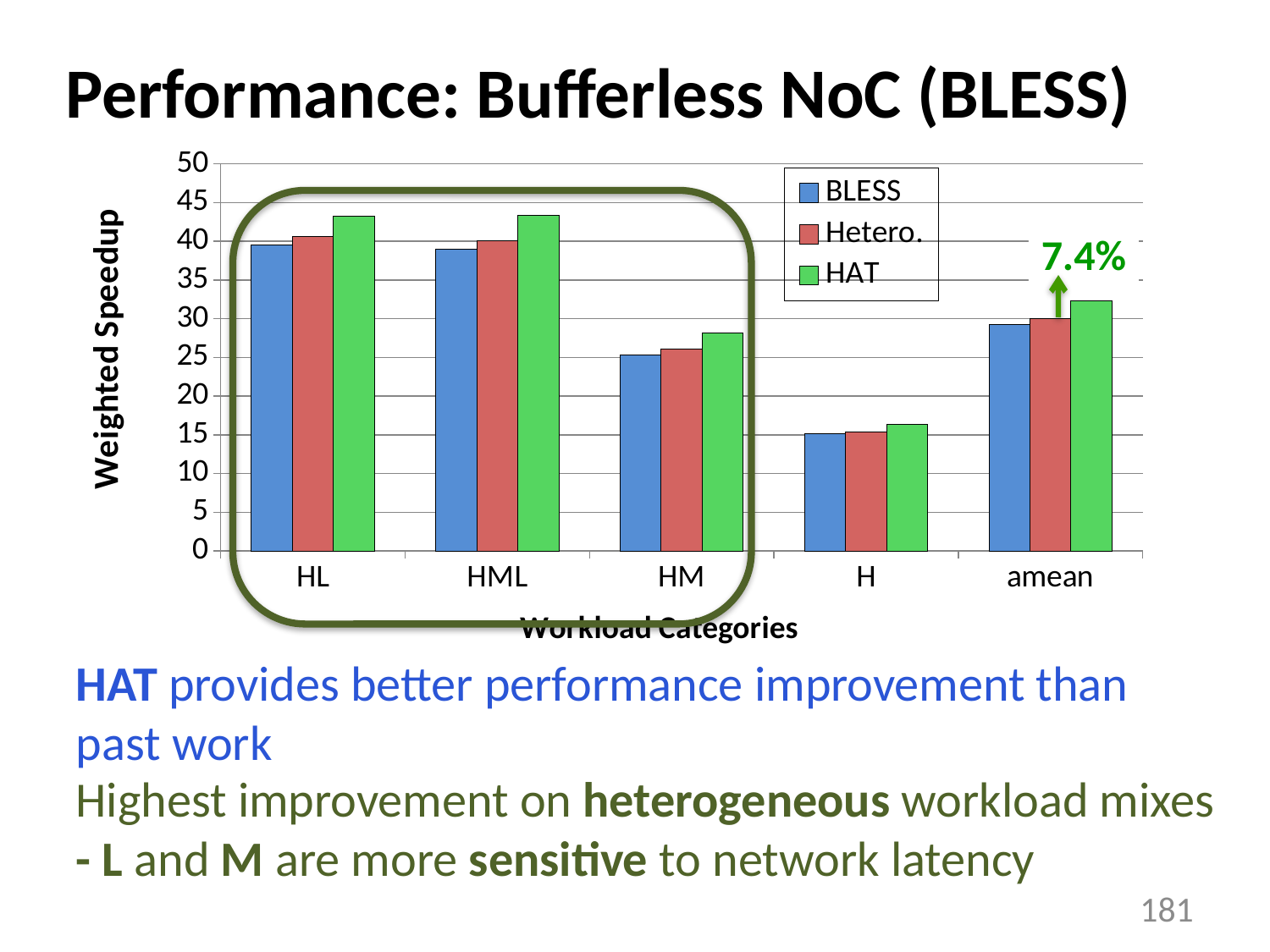
What is the label of the y axis? Weighted Speedup How many series does the legend list? 3 Is the BLESS value for HML greater or less than 40? less How many workload categories are shown on the x axis? 5 What kind of chart is shown on the slide? bar chart Is the BLESS value for H greater or less than 20? less Is the HAT value for HL greater or less than 40? greater Which workload category has the lowest weighted speedup for HAT? H Which workload category has the lowest weighted speedup for BLESS? H For the HM category, which is larger: the HAT value or the BLESS value? HAT What percentage improvement is annotated above the amean group? 7.4%